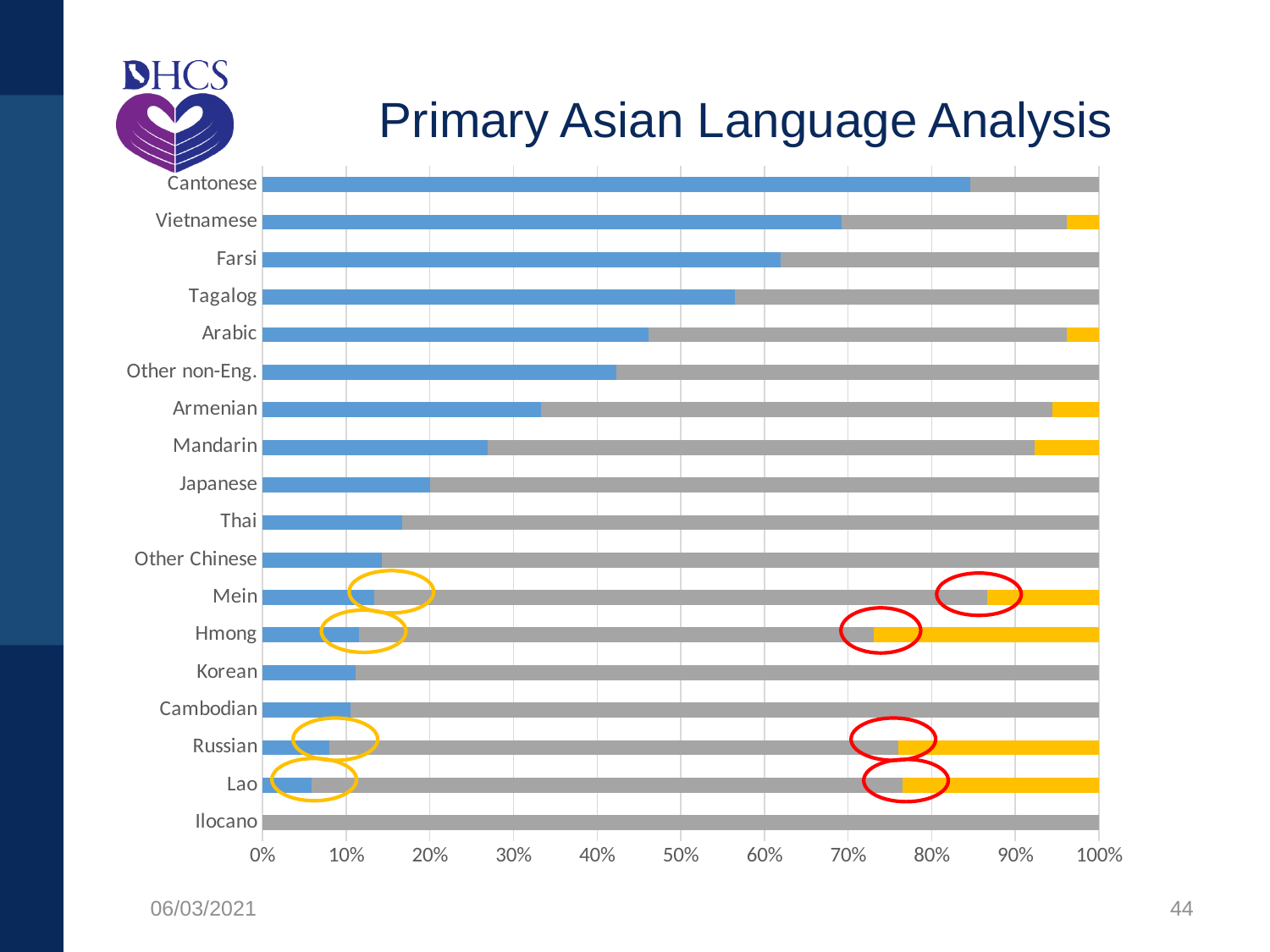
Which has a longer blue segment, Vietnamese or Farsi? Vietnamese What type of chart is shown on the slide? bar chart Is the blue segment for Arabic greater or less than 50%? less Is the blue segment for Cantonese greater or less than 80%? greater What is the title of the chart? Primary Asian Language Analysis How many languages are listed on the chart? 18 Which has a longer yellow segment, Hmong or Mein? Hmong Which language has the longest blue segment? Cantonese Do the blue segments get longer or shorter going from the top of the chart to the bottom? shorter Is the blue segment for Tagalog greater or less than 50%? greater Which language has no blue segment at all? Ilocano